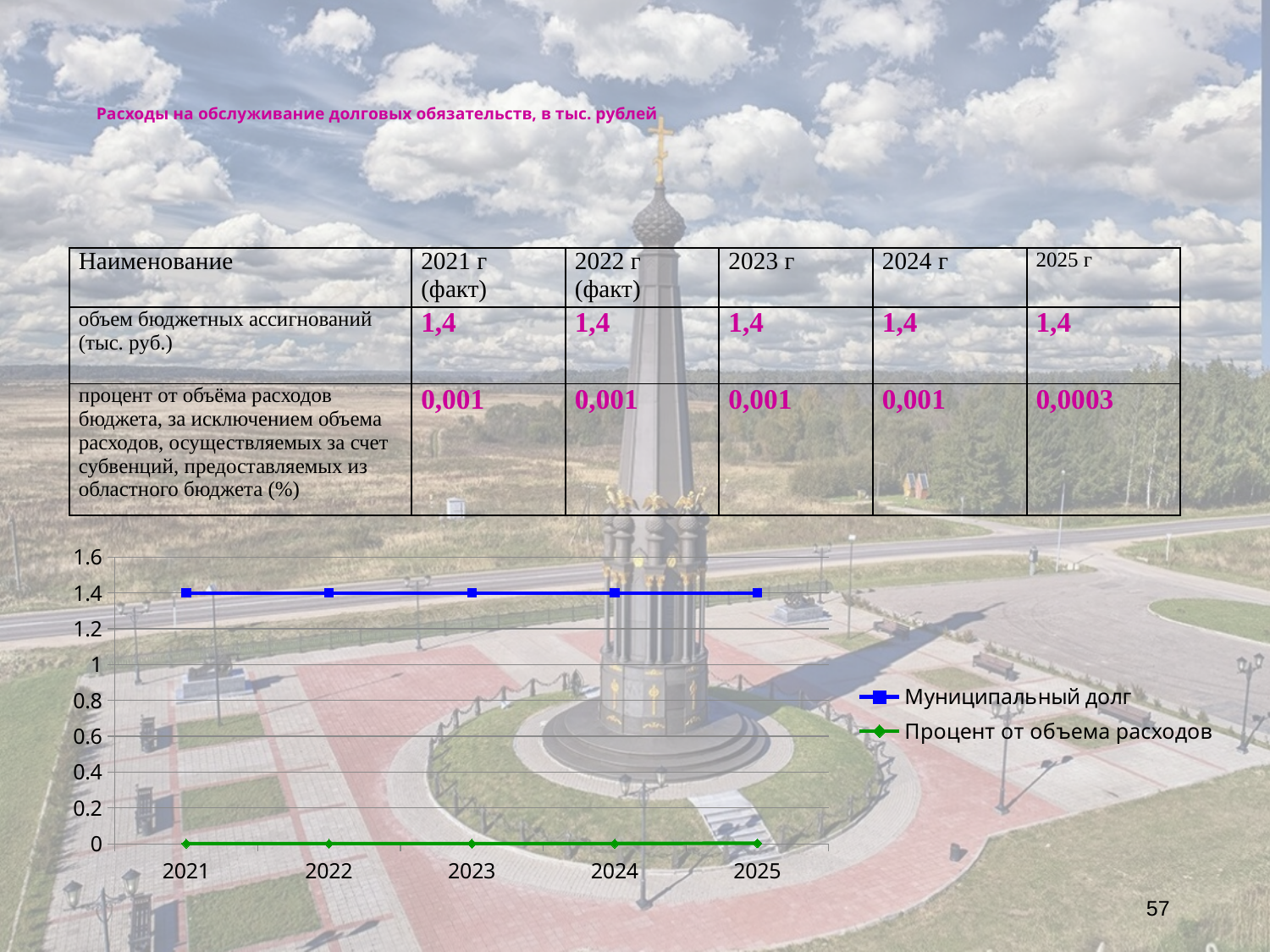
Is the value for Процент от объема расходов in 2024 greater or less than 0.2? less Is the value for Муниципальный долг in 2025 greater or less than 1? greater Which series has the higher value in 2022, Муниципальный долг or Процент от объема расходов? Муниципальный долг Does the Муниципальный долг line rise, fall or stay flat from 2021 to 2025? stays flat What is the first year shown on the x axis of the chart? 2021 What is the value of Муниципальный долг in 2021 on the chart? 1.4 How many series does the chart legend list? 2 What colour is the Муниципальный долг line on the chart? blue What kind of chart is shown on the slide? line chart What is the value of Муниципальный долг in 2023 on the chart? 1.4 How many years are shown along the x axis of the chart? 5 What are the two entries in the chart legend? Муниципальный долг, Процент от объема расходов